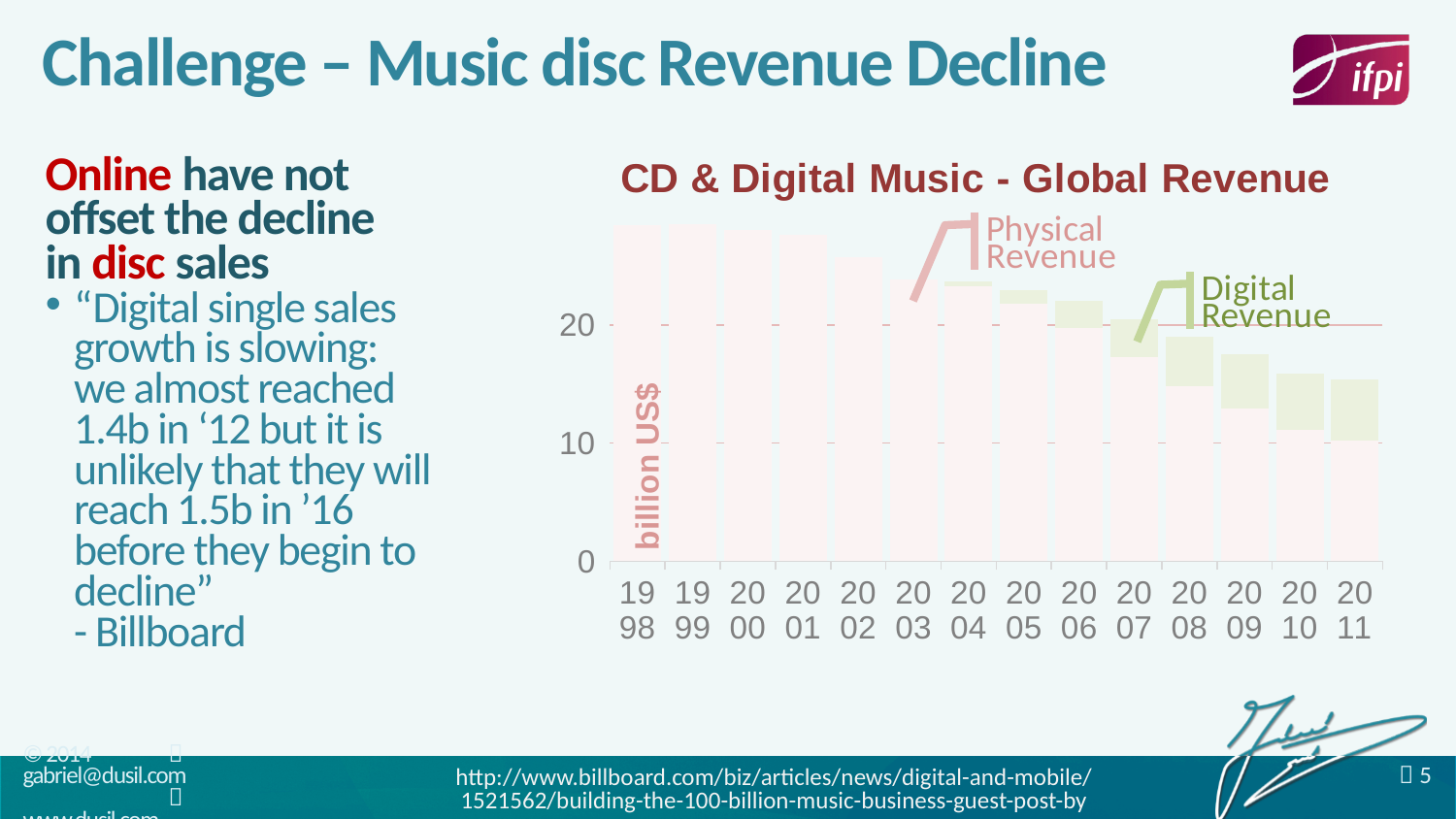
What are the two series named in the chart's legend? Physical Revenue and Digital Revenue What kind of chart is shown on the slide? Stacked bar chart Which year has the larger total revenue bar, 1998 or 2011? 1998 What is the title of the chart? CD & Digital Music - Global Revenue Is the total revenue bar for 1998 greater or less than 20 billion US$? greater What is the label on the vertical axis of the chart? billion US$ Does Physical Revenue rise or fall from 1998 to 2011? Fall Is the total revenue bar for 2011 greater or less than 20 billion US$? less Is the Physical Revenue for 2008 greater or less than 20 billion US$? less How many series does the chart's legend list? 2 Which year has the larger Physical Revenue, 2003 or 2009? 2003 How many years are shown along the x axis of the chart? 14